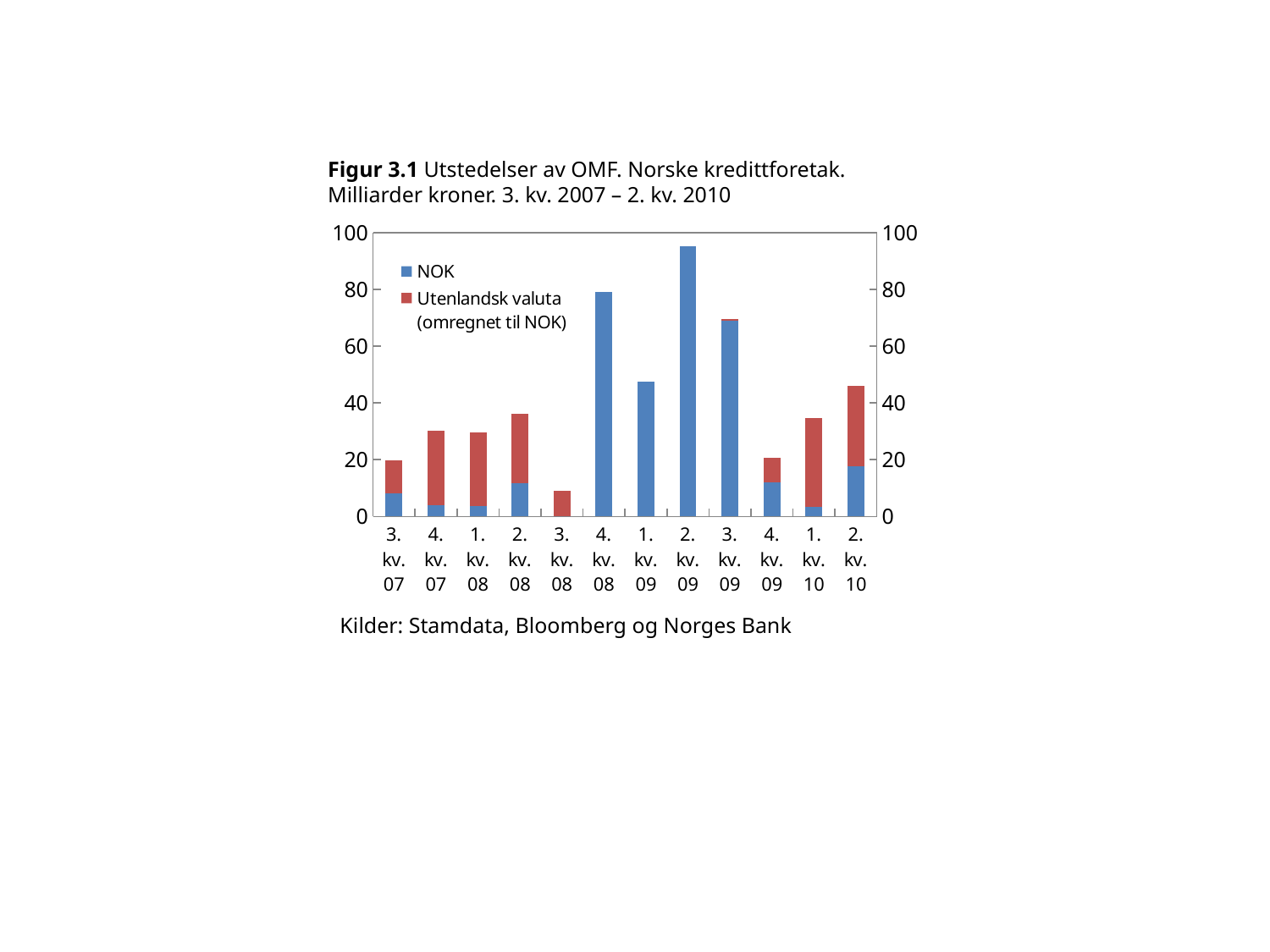
How many series does the legend list? 2 Which series is shown in red in the legend? Utenlandsk valuta (omregnet til NOK) Is the total value for 1. kv. 09 greater or less than 60? less What unit does the chart title say the values are in? Milliarder kroner Which quarter has the lowest total bar? 3. kv. 08 Is the total value for 3. kv. 08 greater or less than 20? less Which has the larger total bar, 4. kv. 08 or 1. kv. 09? 4. kv. 08 Which quarter has the highest total bar? 2. kv. 09 What kind of chart is shown on the slide? Stacked bar chart Is the total value for 4. kv. 08 greater or less than 60? greater How many quarters (categories) are plotted on the x axis? 12